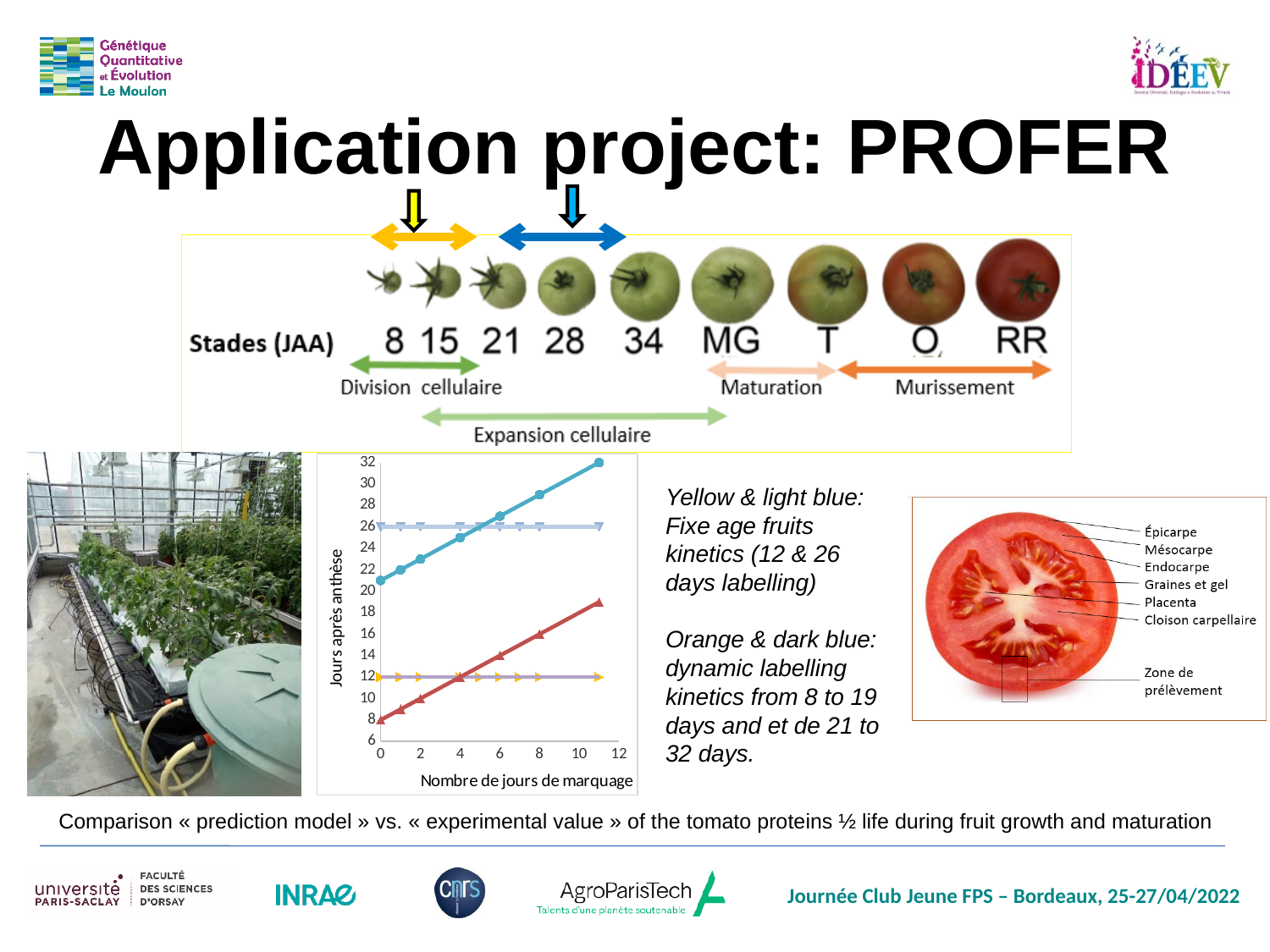
Does the dark blue line rise or fall as 'Nombre de jours de marquage' increases? rise At what value of 'Jours après anthèse' does the flat light blue line sit? 26 What kind of chart is shown on the slide? line chart At 0 days of labelling, which line is higher: the dark blue line or the orange line? dark blue line What is the title of the x axis of the chart? Nombre de jours de marquage At what value of 'Jours après anthèse' does the flat yellow line sit? 12 What is the title of the y axis of the chart? Jours après anthèse How many lines are plotted on the chart? 4 Does the orange line rise or fall as 'Nombre de jours de marquage' increases? rise Is the value of the orange line at 0 days of labelling greater or less than 10? less